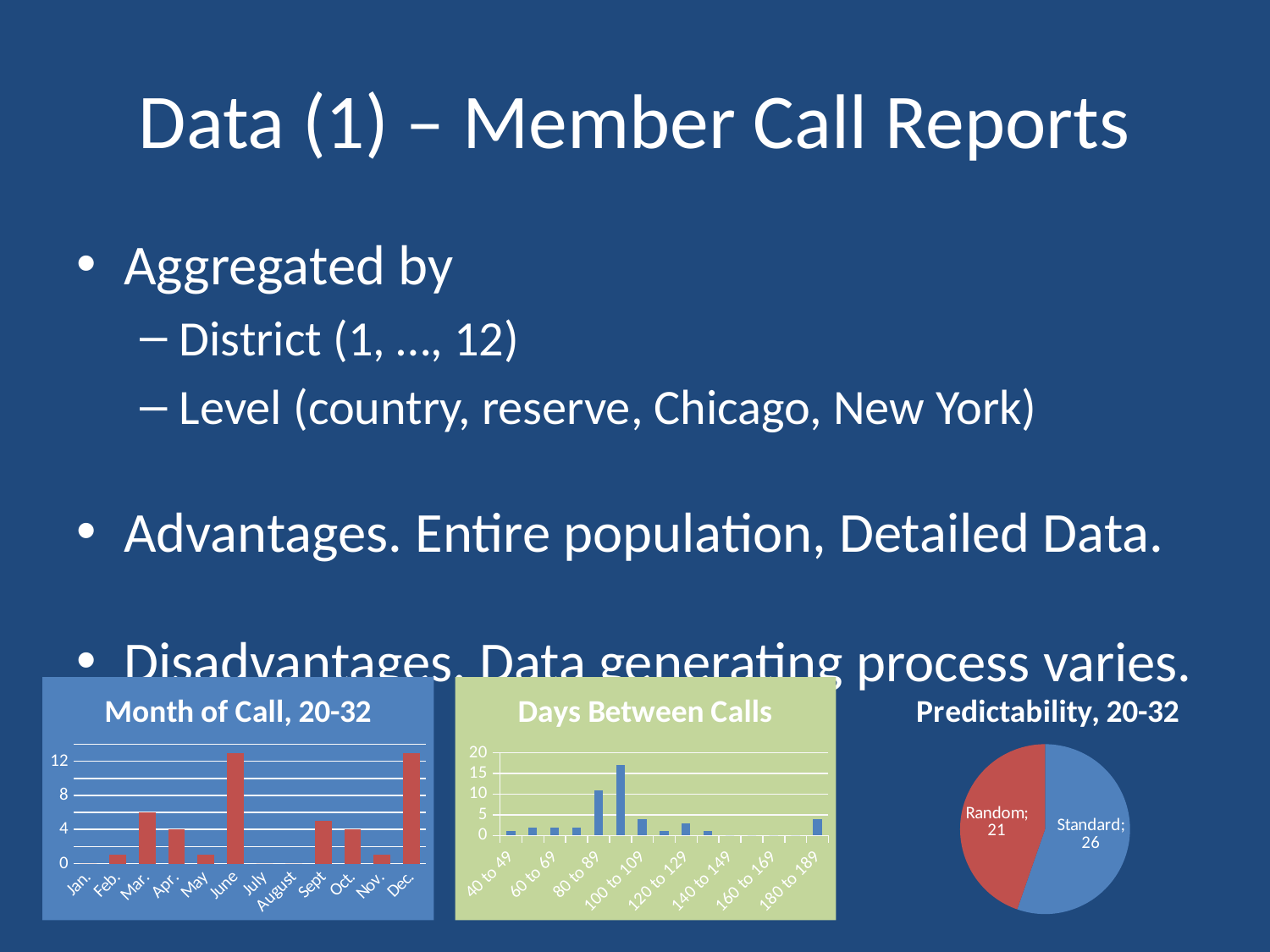
What kind of chart is the 'Days Between Calls' chart? bar chart In the 'Predictability, 20-32' pie chart, what is the value for Standard? 26 What kind of chart is the 'Month of Call, 20-32' chart? bar chart How many months are shown on the x axis of the 'Month of Call, 20-32' chart? 12 What kind of chart is the 'Predictability, 20-32' chart? pie chart In the 'Month of Call, 20-32' chart, is the value for Feb. greater or less than 4? less In the 'Month of Call, 20-32' chart, is the value for Mar. greater or less than 4? greater In the 'Days Between Calls' chart, is the tallest bar greater or less than 15? greater In the 'Predictability, 20-32' pie chart, what is the difference between the Standard and Random values? 5 In the 'Month of Call, 20-32' chart, which is larger, the value for Mar. or the value for May? Mar.